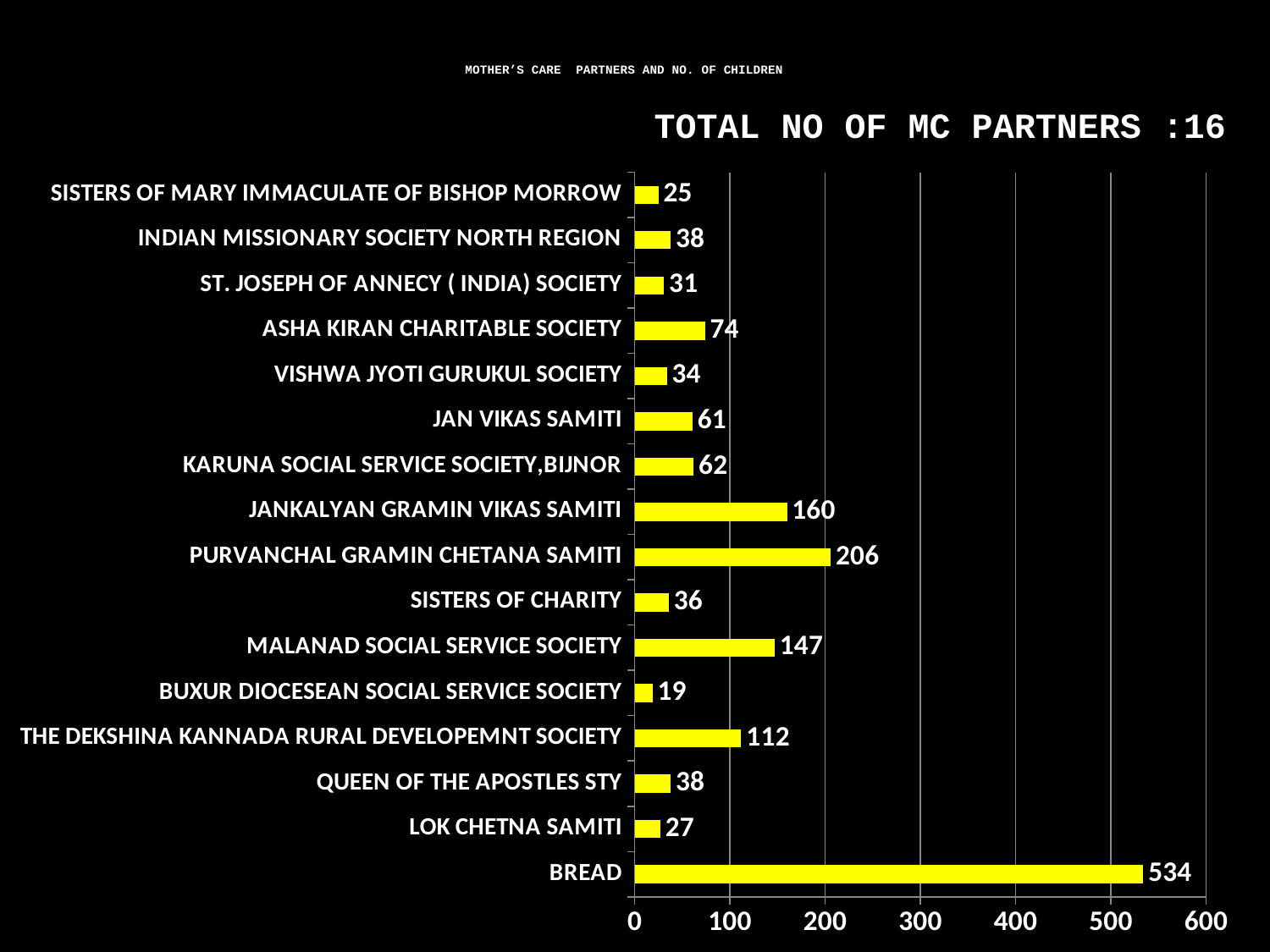
What is the number of children for BREAD? 534 What is the difference in number of children between JANKALYAN GRAMIN VIKAS SAMITI and MALANAD SOCIAL SERVICE SOCIETY? 13 Which partner has the highest number of children? BREAD How many partners are shown in the chart? 16 Which partner has the lowest number of children? BUXUR DIOCESAN SOCIAL SERVICE SOCIETY Which has more children, ASHA KIRAN CHARITABLE SOCIETY or THE DEKSHINA KANNADA RURAL DEVELOPEMNT SOCIETY? THE DEKSHINA KANNADA RURAL DEVELOPEMNT SOCIETY What is the number of children for LOK CHETNA SAMITI? 27 What kind of chart is shown on the slide? bar chart What is the number of children for PURVANCHAL GRAMIN CHETANA SAMITI? 206 What is the number of children for BUXUR DIOCESAN SOCIAL SERVICE SOCIETY? 19 What colour are the bars in the chart? yellow Is the value for BREAD greater or less than 500? greater